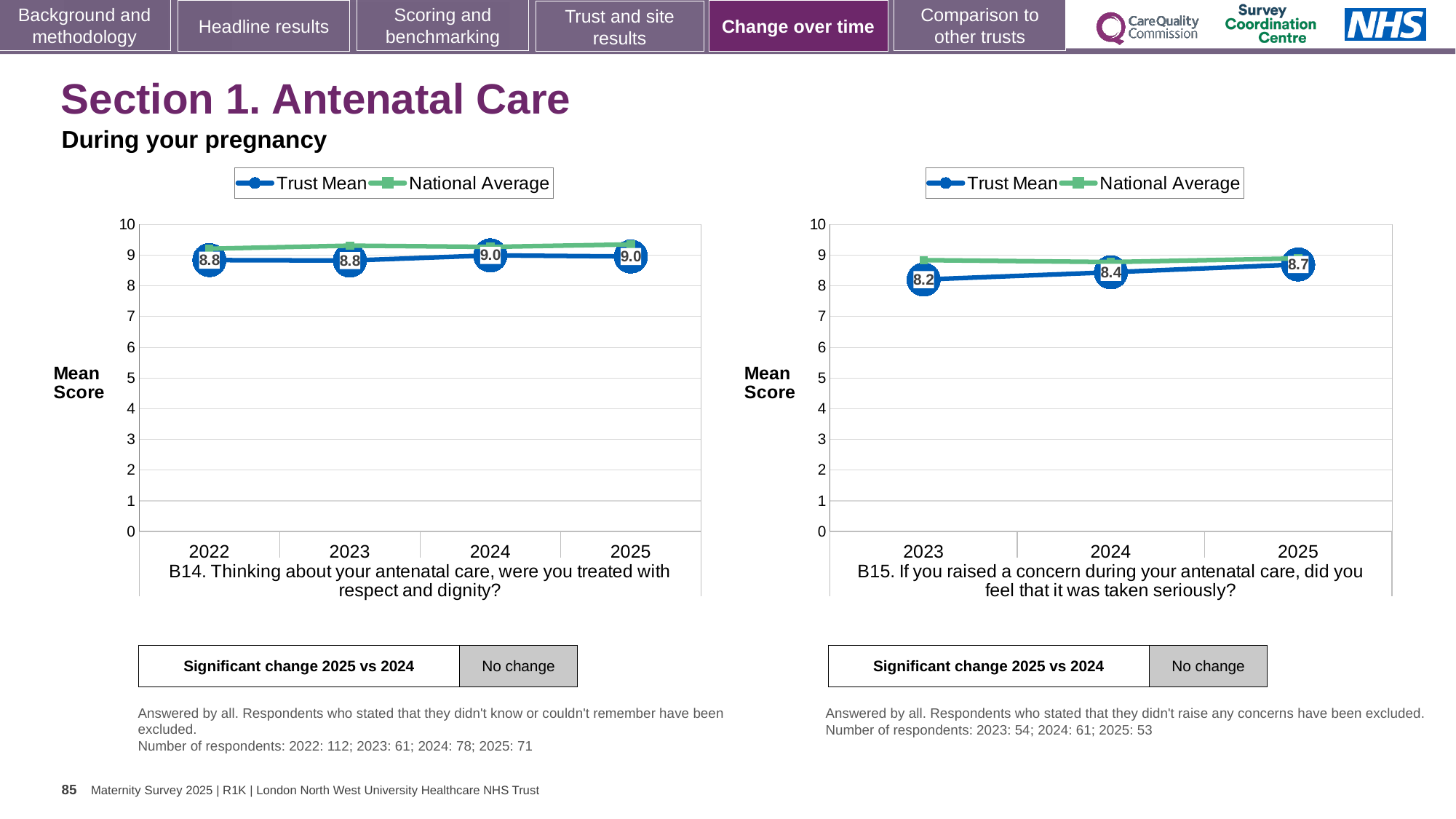
In the B15 chart (right), does the Trust Mean score rise or fall from 2023 to 2025? Rise How many series does the legend of the B15 chart (right) list? 2 In the B15 chart (right), which year has the lowest Trust Mean score? 2023 What kind of chart is the B14 chart (left)? Line chart In the B14 chart (left), what is the Trust Mean score for 2025? 9.0 In the B15 chart (right), is the Trust Mean score for 2024 greater or less than 8? greater In the B14 chart (left), what is the Trust Mean score for 2022? 8.8 In the B14 chart (left), what is the difference between the Trust Mean scores for 2024 and 2023? 0.2 In the B15 chart (right), what is the difference between the Trust Mean scores for 2025 and 2023? 0.5 How many years are shown on the x axis of the B14 chart (left)? 4 In the B15 chart (right), what is the Trust Mean score for 2025? 8.7 In the B15 chart (right), what is the Trust Mean score for 2023? 8.2